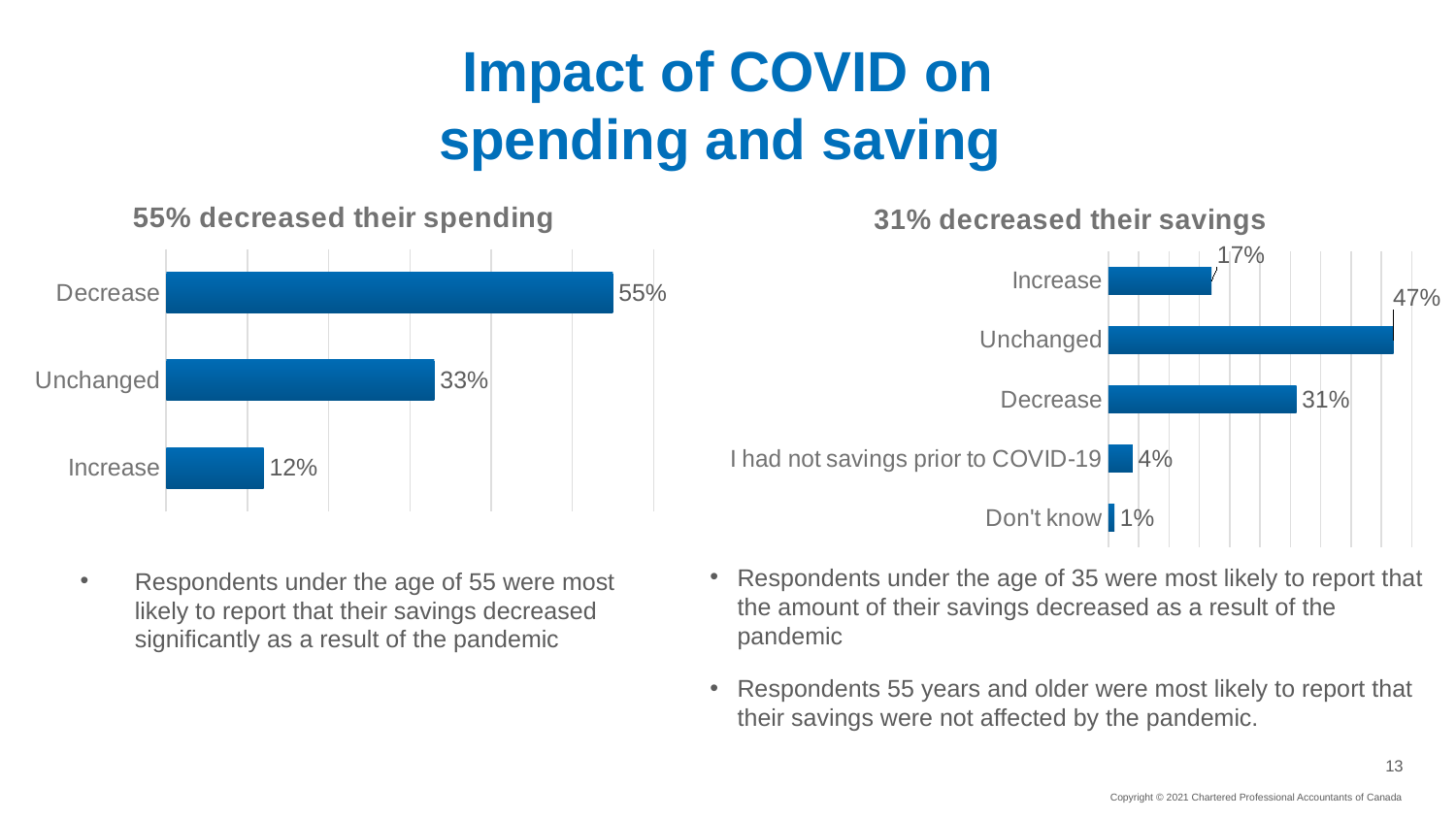
In the '31% decreased their savings' chart, what is the value for Unchanged? 47% In the '31% decreased their savings' chart, what is the value for 'I had not savings prior to COVID-19'? 4% In the '55% decreased their spending' chart, what is the difference between Decrease and Unchanged? 22% In the '55% decreased their spending' chart, what is the value for Increase? 12% In the '31% decreased their savings' chart, how many categories are shown? 5 In the '31% decreased their savings' chart, what is the difference between Unchanged and Decrease? 16% In the '55% decreased their spending' chart, how many categories are shown? 3 In the '31% decreased their savings' chart, which is larger, Increase or Decrease? Decrease In the '55% decreased their spending' chart, which category has the highest value? Decrease What type of chart is the '31% decreased their savings' chart? Bar chart In the '55% decreased their spending' chart, what is the value for Unchanged? 33% In the '31% decreased their savings' chart, which category has the lowest value? Don't know